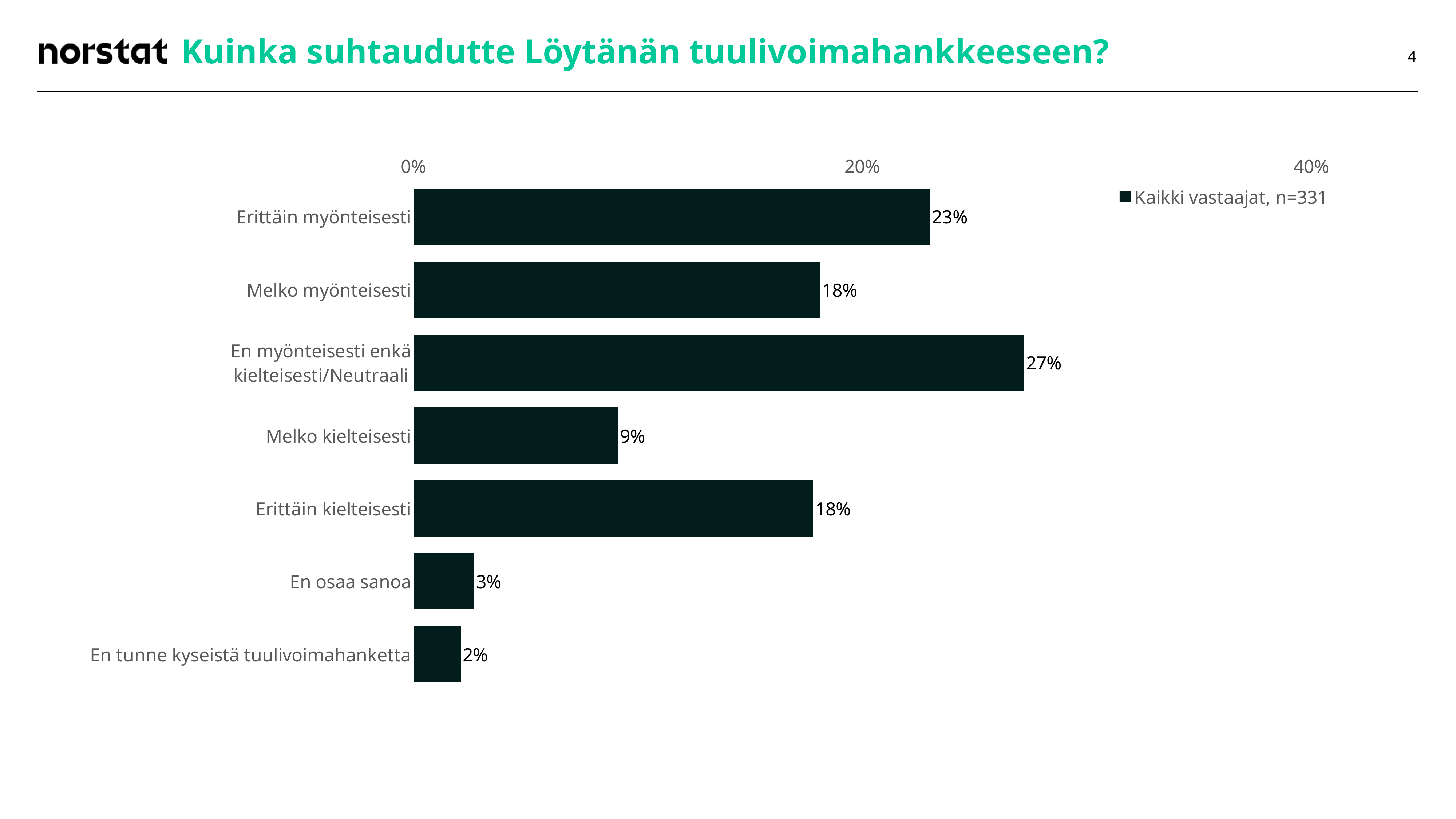
What is the difference between the values for "Erittäin myönteisesti" and "Melko myönteisesti"? 5% What is the value for "En tunne kyseistä tuulivoimahanketta"? 2% What kind of chart is shown on the slide? bar chart What is the legend entry of the chart? Kaikki vastaajat, n=331 What is the value for "En myönteisesti enkä kielteisesti/Neutraali"? 27% Is the value for "En myönteisesti enkä kielteisesti/Neutraali" greater or less than 20%? greater Which is larger, the value for "Erittäin myönteisesti" or the value for "Erittäin kielteisesti"? Erittäin myönteisesti Which category has the highest value? En myönteisesti enkä kielteisesti/Neutraali How many categories are shown in the chart? 7 What is the value for "Erittäin myönteisesti"? 23% Which category has the lowest value? En tunne kyseistä tuulivoimahanketta What is the value for "Melko kielteisesti"? 9%